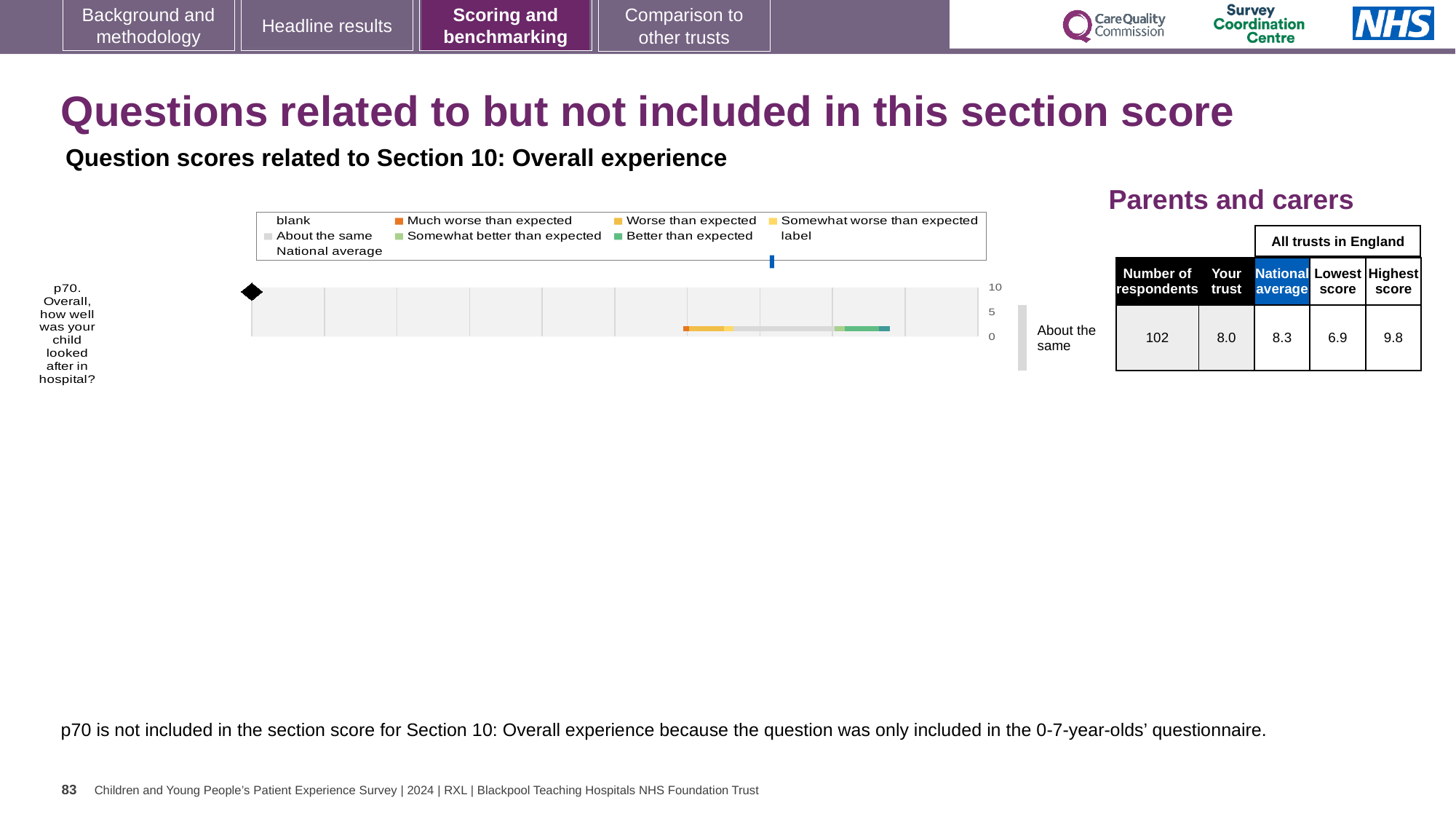
How many questions are plotted in the chart? 1 What category label is shown to the right of the p70 bar? About the same Which question is plotted in the chart? p70. Overall, how well was your child looked after in hospital? What is the 'Your trust' score for p70 in the Parents and carers table? 8.0 What is the difference between the Highest score and the Lowest score for p70? 2.9 What is the Highest score among all trusts in England for p70? 9.8 What is the difference between the National average and the 'Your trust' score for p70? 0.3 What kind of chart is used to show the p70 question score? bar chart What is the Lowest score among all trusts in England for p70? 6.9 What is the National average score for p70 in the Parents and carers table? 8.3 For p70, which is larger: the 'Your trust' score or the National average? National average How many respondents answered p70 according to the Parents and carers table? 102